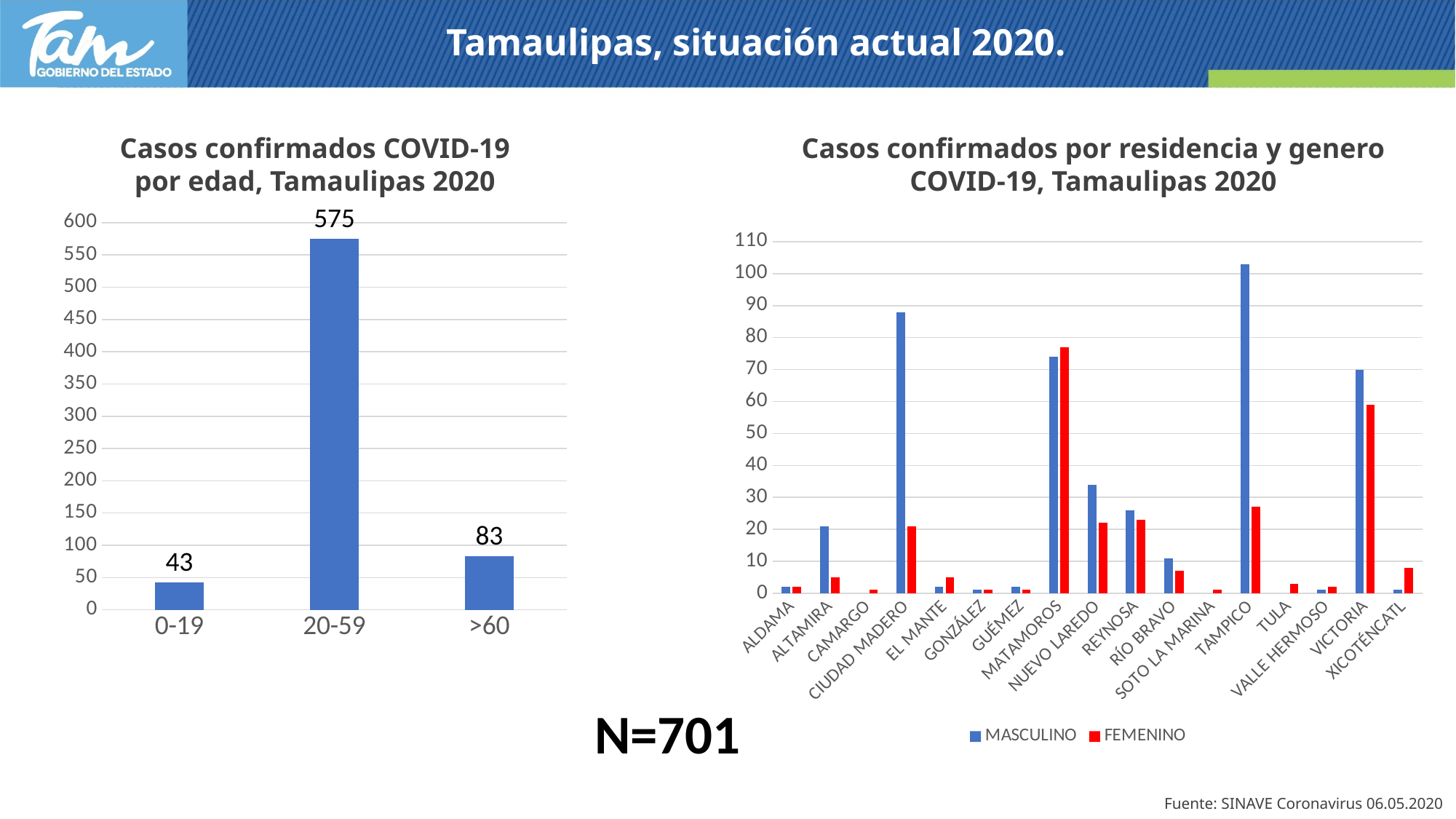
In the chart 'Casos confirmados por residencia y genero COVID-19, Tamaulipas 2020', is the FEMENINO value for TAMPICO greater or less than 40? less In the chart 'Casos confirmados COVID-19 por edad, Tamaulipas 2020', what is the value for the 0-19 age group? 43 In the chart 'Casos confirmados COVID-19 por edad, Tamaulipas 2020', what is the value for the 20-59 age group? 575 In the chart 'Casos confirmados por residencia y genero COVID-19, Tamaulipas 2020', which municipality has the highest MASCULINO value? TAMPICO In the chart 'Casos confirmados COVID-19 por edad, Tamaulipas 2020', which age group has the lowest number of cases? 0-19 In the chart 'Casos confirmados COVID-19 por edad, Tamaulipas 2020', which is larger, the value for >60 or the value for 0-19? >60 In the chart 'Casos confirmados COVID-19 por edad, Tamaulipas 2020', how many age groups are shown? 3 In the chart 'Casos confirmados por residencia y genero COVID-19, Tamaulipas 2020', is the MASCULINO value for CIUDAD MADERO greater or less than 80? greater In the chart 'Casos confirmados por residencia y genero COVID-19, Tamaulipas 2020', which is larger for VICTORIA, the MASCULINO or the FEMENINO value? MASCULINO In the chart 'Casos confirmados COVID-19 por edad, Tamaulipas 2020', what is the difference between the 20-59 and >60 age groups? 492 In the chart 'Casos confirmados por residencia y genero COVID-19, Tamaulipas 2020', how many series does the legend list? 2 What type of chart is 'Casos confirmados por residencia y genero COVID-19, Tamaulipas 2020'? Bar chart